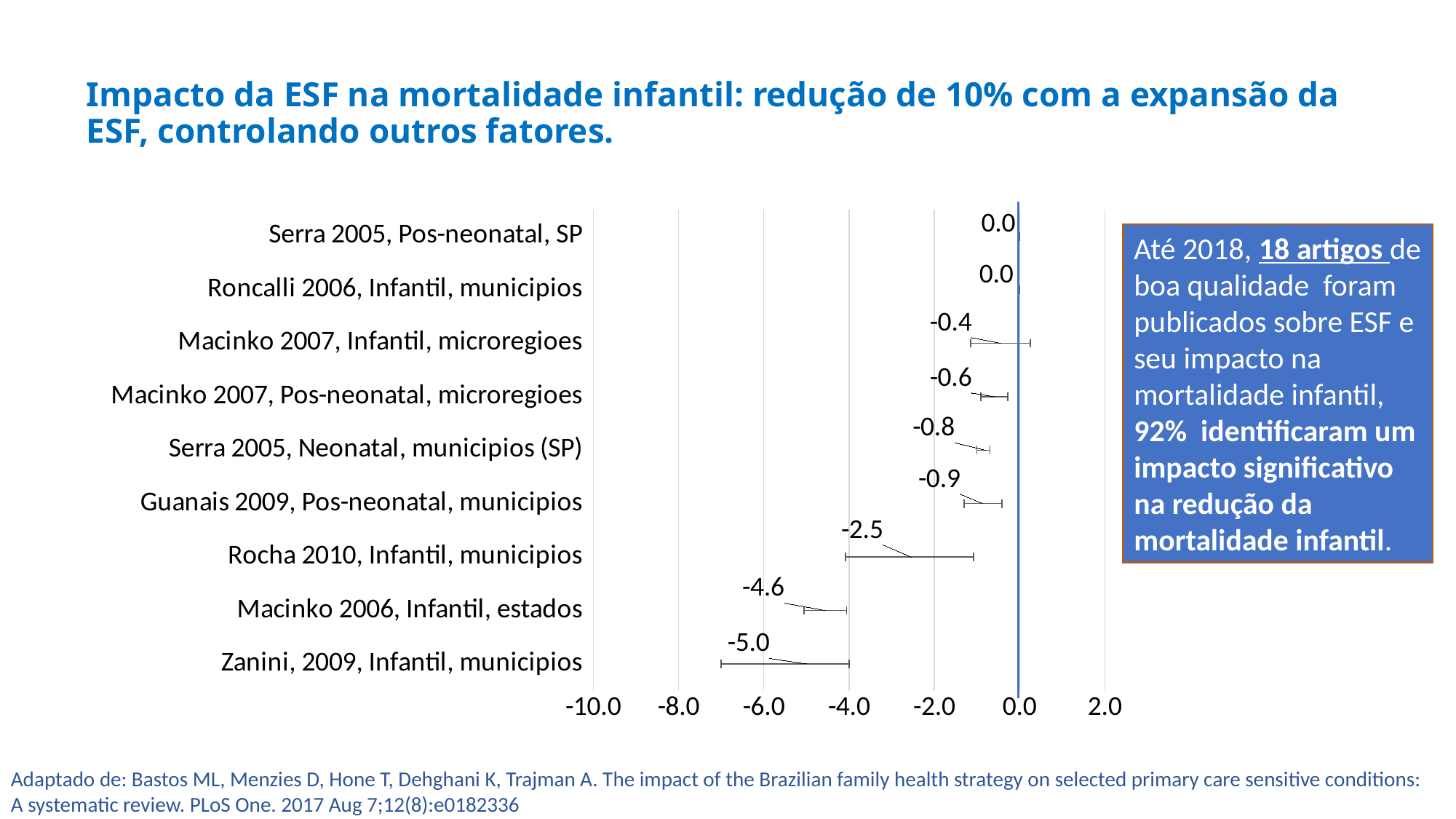
What value is shown for Roncalli 2006, Infantil, municipios? 0.0 How many studies are listed as categories in the chart? 9 Which has a more negative value: Serra 2005, Neonatal, municipios (SP) or Macinko 2007, Pos-neonatal, microregioes? Serra 2005, Neonatal, municipios (SP) What is the difference between the values for Zanini, 2009, Infantil, municipios and Macinko 2006, Infantil, estados? 0.4 What is the difference between the values for Rocha 2010, Infantil, municipios and Guanais 2009, Pos-neonatal, municipios? 1.6 What is the value shown for Rocha 2010, Infantil, municipios? -2.5 Which study has the lowest (most negative) value in the chart? Zanini, 2009, Infantil, municipios What is the value shown for Macinko 2007, Infantil, microregioes? -0.4 What is the value shown for Macinko 2006, Infantil, estados? -4.6 What is the value shown for Guanais 2009, Pos-neonatal, municipios? -0.9 What is the value shown for Zanini, 2009, Infantil, municipios? -5.0 What kind of chart is shown on the slide? Bar chart